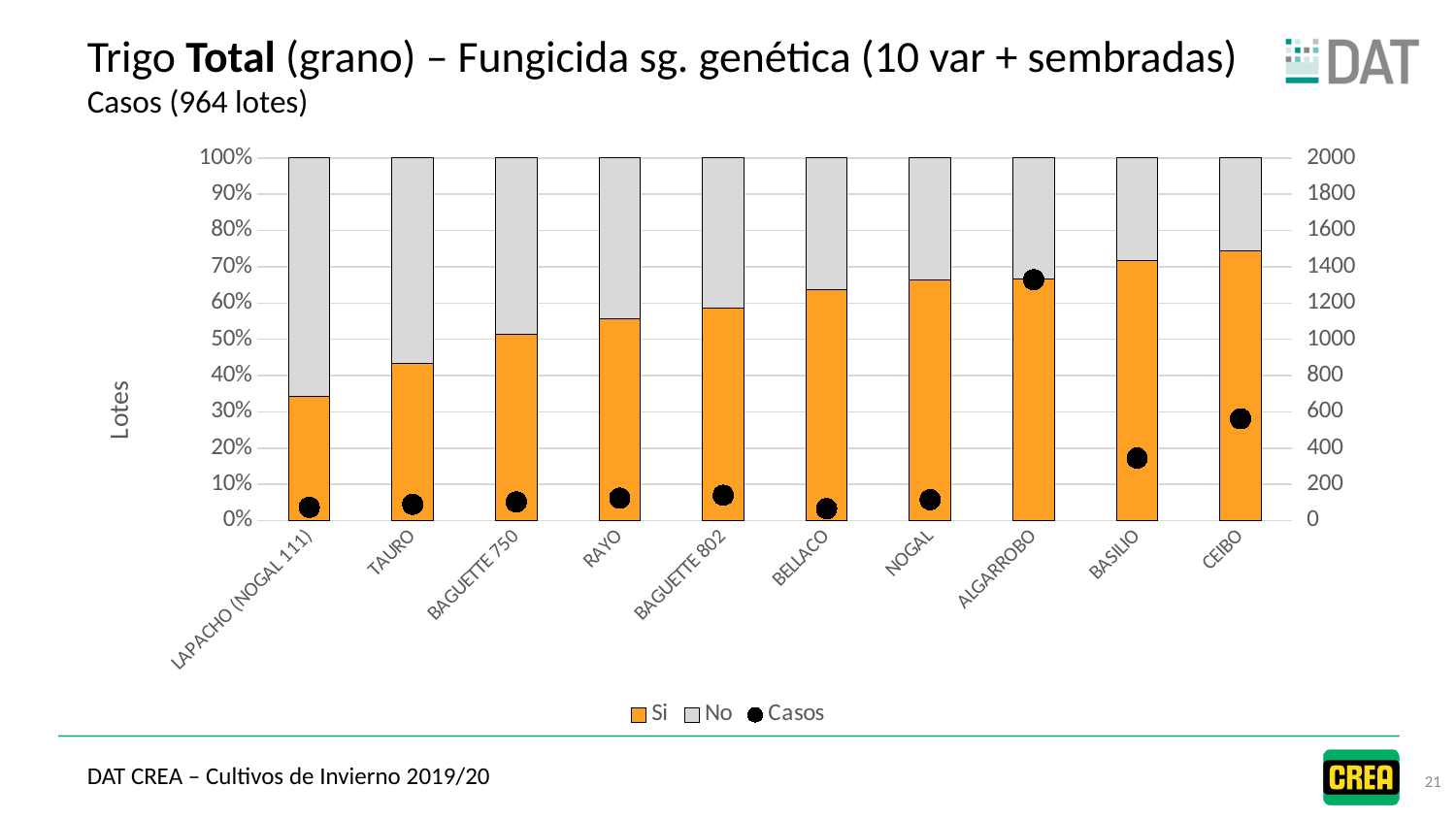
Is the 'Si' share for LAPACHO (NOGAL 111) greater or less than 40%? less Which variety has the highest number of 'Casos' (black dot)? ALGARROBO Which has more 'Casos', CEIBO or BASILIO? CEIBO Which has a larger 'Si' share, BASILIO or TAURO? BASILIO Is the 'Casos' value for ALGARROBO greater or less than 1200? greater What kind of chart is shown on the slide? combination chart: 100% stacked bar chart with a dot (line) series for Casos How many varieties (categories) are shown on the x axis? 10 Does the 'Si' share rise or fall moving from left to right along the x axis? rises Is the 'Si' share for CEIBO greater or less than 70%? greater How many series does the legend list? 3 Which variety has the lowest share of 'Si' (orange)? LAPACHO (NOGAL 111)